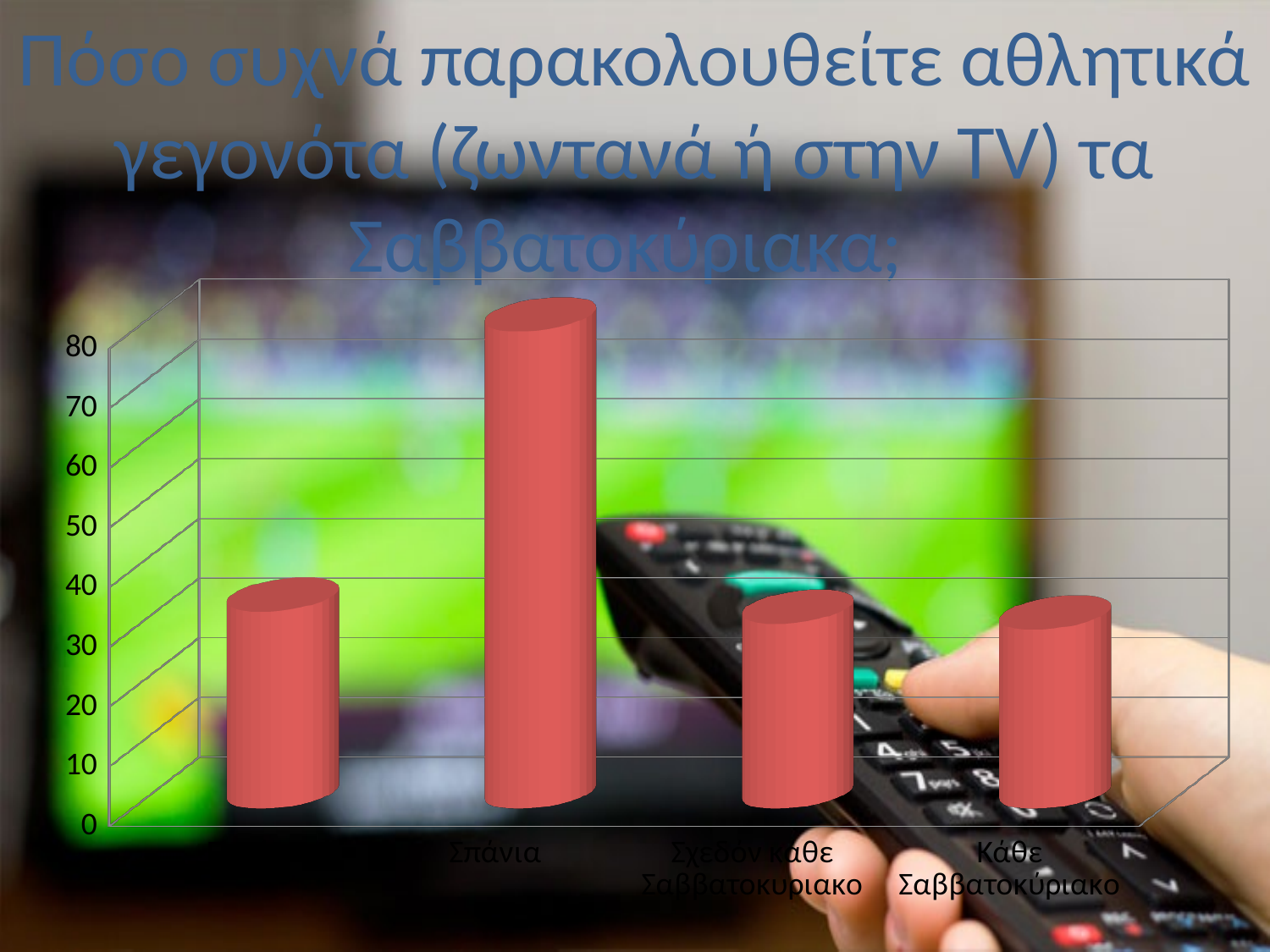
Is the value for Σπάνια greater or less than 60? greater Which is larger, the value for Σπάνια or the value for Σχεδόν κάθε Σαββατοκύριακο? Σπάνια Is the value for Κάθε Σαββατοκύριακο greater or less than 50? less What is the title of the chart on the slide? Πόσο συχνά παρακολουθείτε αθλητικά γεγονότα (ζωντανά ή στην TV) τα Σαββατοκύριακα; What kind of chart is shown on the slide? bar chart What is the highest tick value shown on the vertical axis? 80 Which category has the highest value in the chart? Σπάνια How many bars are plotted in the chart? 4 Is the value for Κάθε Σαββατοκύριακο greater or less than 20? greater Which is larger, the value for Σπάνια or the value for Κάθε Σαββατοκύριακο? Σπάνια